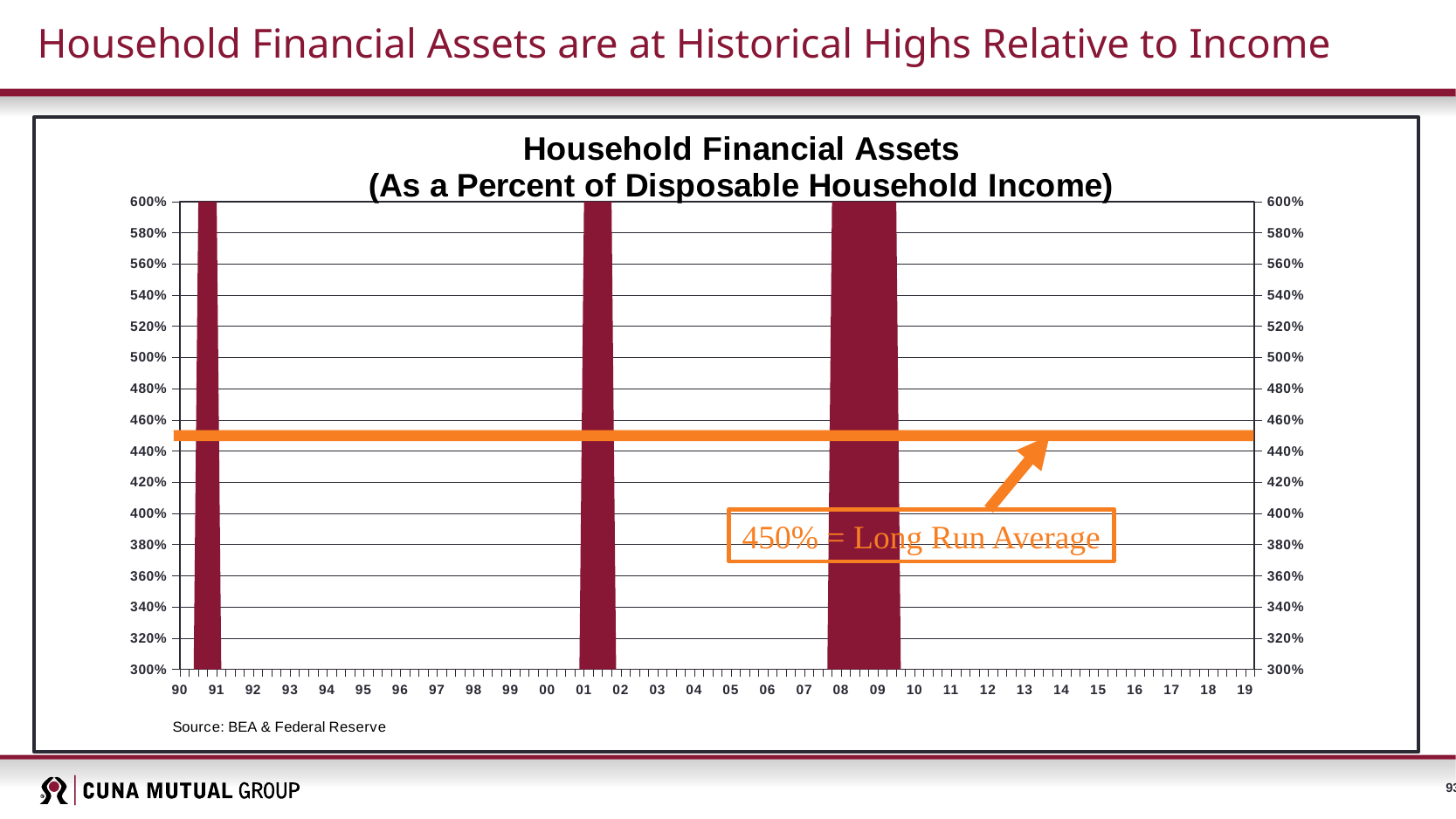
What is the first year label on the horizontal axis of the chart? 90 What is the last year label on the horizontal axis of the chart? 19 What is the highest value shown on the vertical axis of the chart? 600% What is the title of the chart? Household Financial Assets (As a Percent of Disposable Household Income) What is the lowest value shown on the vertical axis of the chart? 300% What value does the orange horizontal line on the chart represent? 450% Is the orange long run average line greater or less than 460%? less Is the orange long run average line greater or less than 440%? greater What source is cited for the chart? BEA & Federal Reserve How many maroon shaded bars appear on the chart? 3 According to the chart's annotation, what is the long run average of household financial assets as a percent of disposable household income? 450%